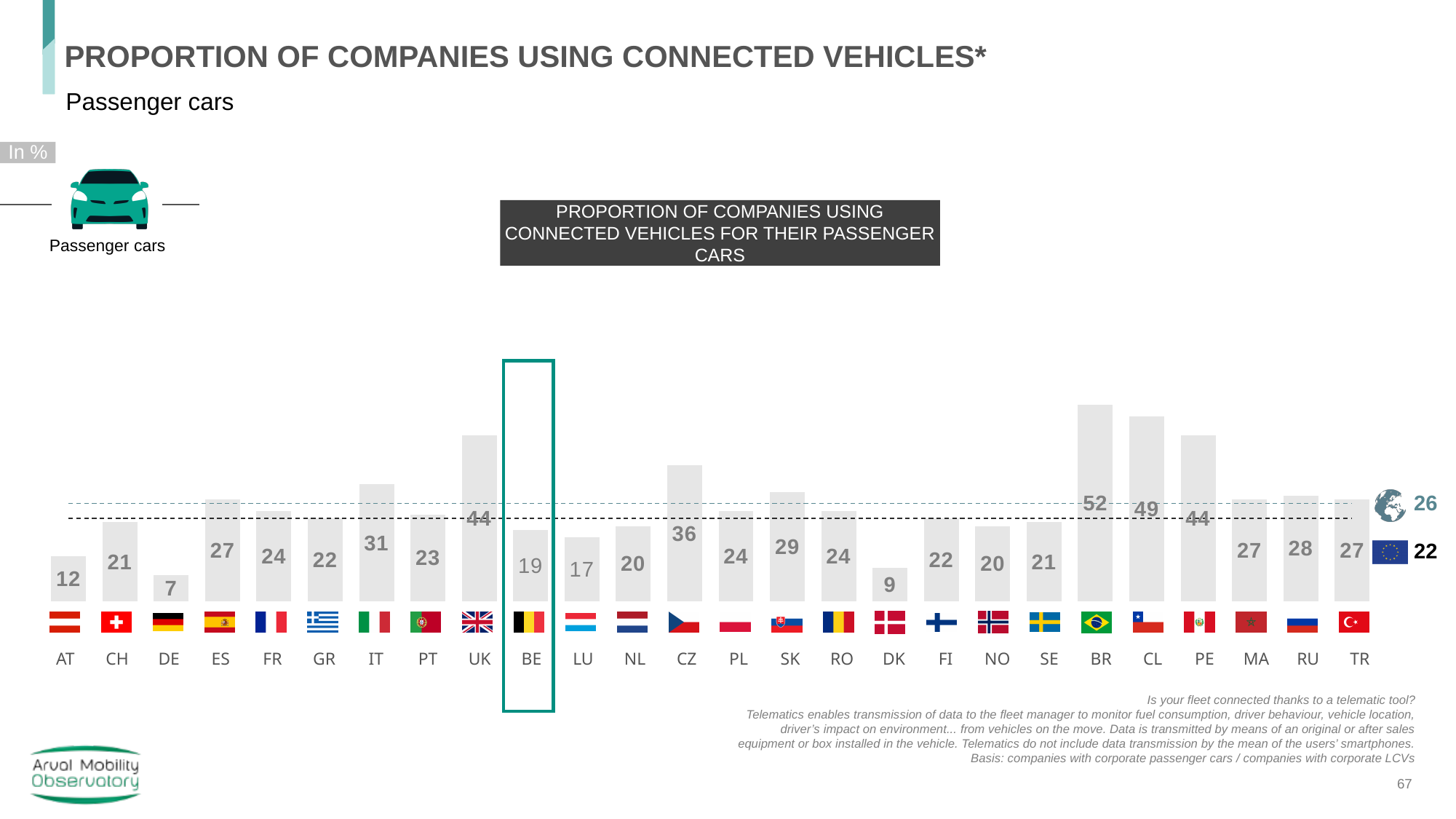
What kind of chart is shown on the slide? Bar chart How many countries are shown in the chart? 26 What value is shown next to the globe icon at the right of the chart? 26 Which has a larger value, DK or AT? AT What is the difference between the values for BR and CL? 3 What is the value for BE (Belgium) in the chart? 19 Which country has the lowest value in the chart? DE Which country has the highest value in the chart? BR What is the difference between the values for IT and PT? 8 What is the value for CZ in the chart? 36 Which has a larger value, SK or RU? SK What is the value for UK in the chart? 44